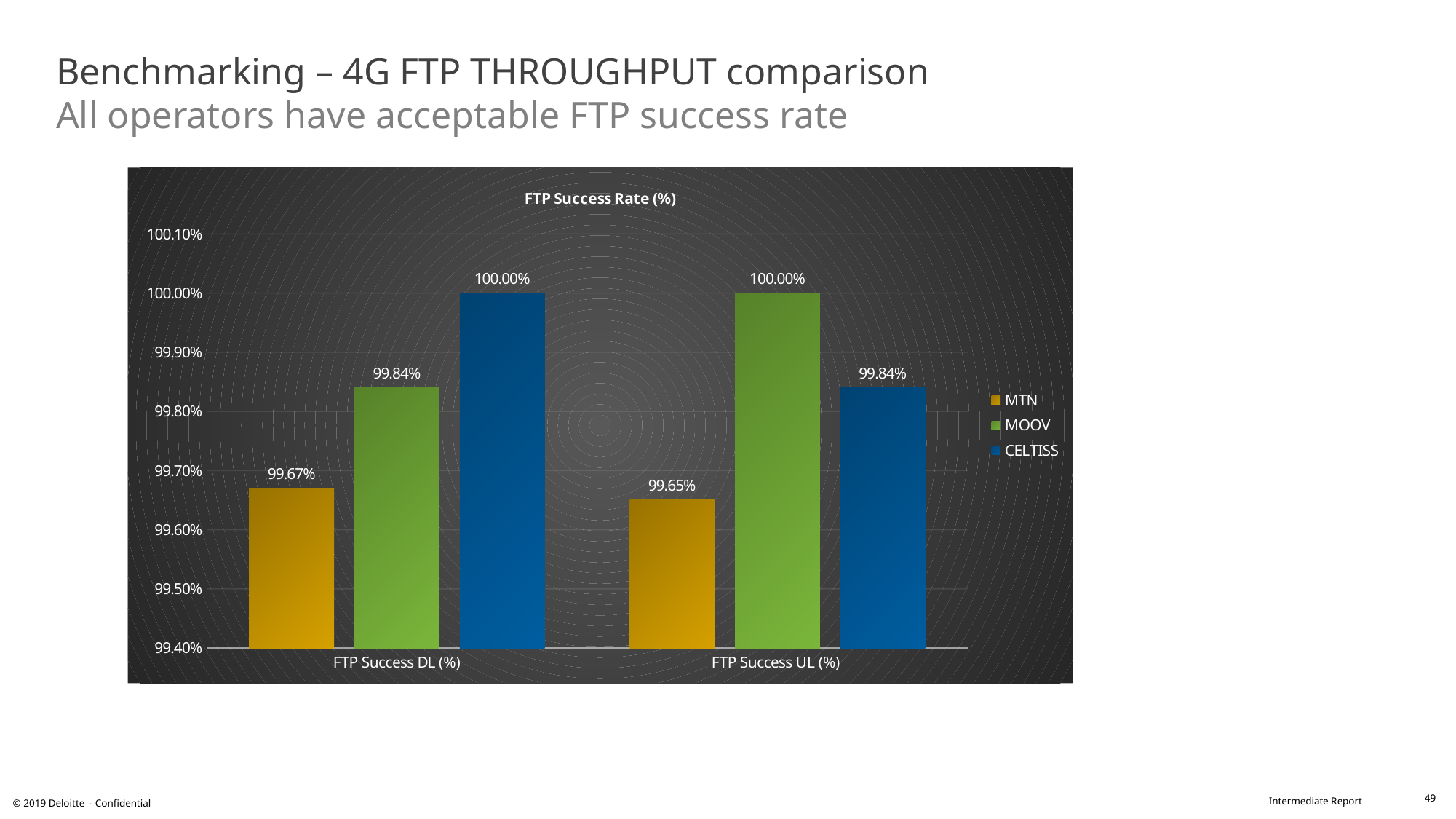
Which operator has the lowest FTP Success UL (%)? MTN What is the difference between CELTISS and MTN for FTP Success DL (%)? 0.33% Which operator has the highest FTP Success DL (%)? CELTISS What is the FTP Success UL (%) value for CELTISS? 99.84% Which is larger: MOOV's FTP Success UL (%) or CELTISS's FTP Success UL (%)? MOOV What kind of chart is shown on the slide? Bar chart What is the FTP Success DL (%) value for MTN? 99.67% What is the FTP Success UL (%) value for MTN? 99.65% What is the title of the chart? FTP Success Rate (%) Is the FTP Success DL (%) value for MTN greater or less than 99.70%? less How many series does the legend list? 3 What is the FTP Success DL (%) value for MOOV? 99.84%